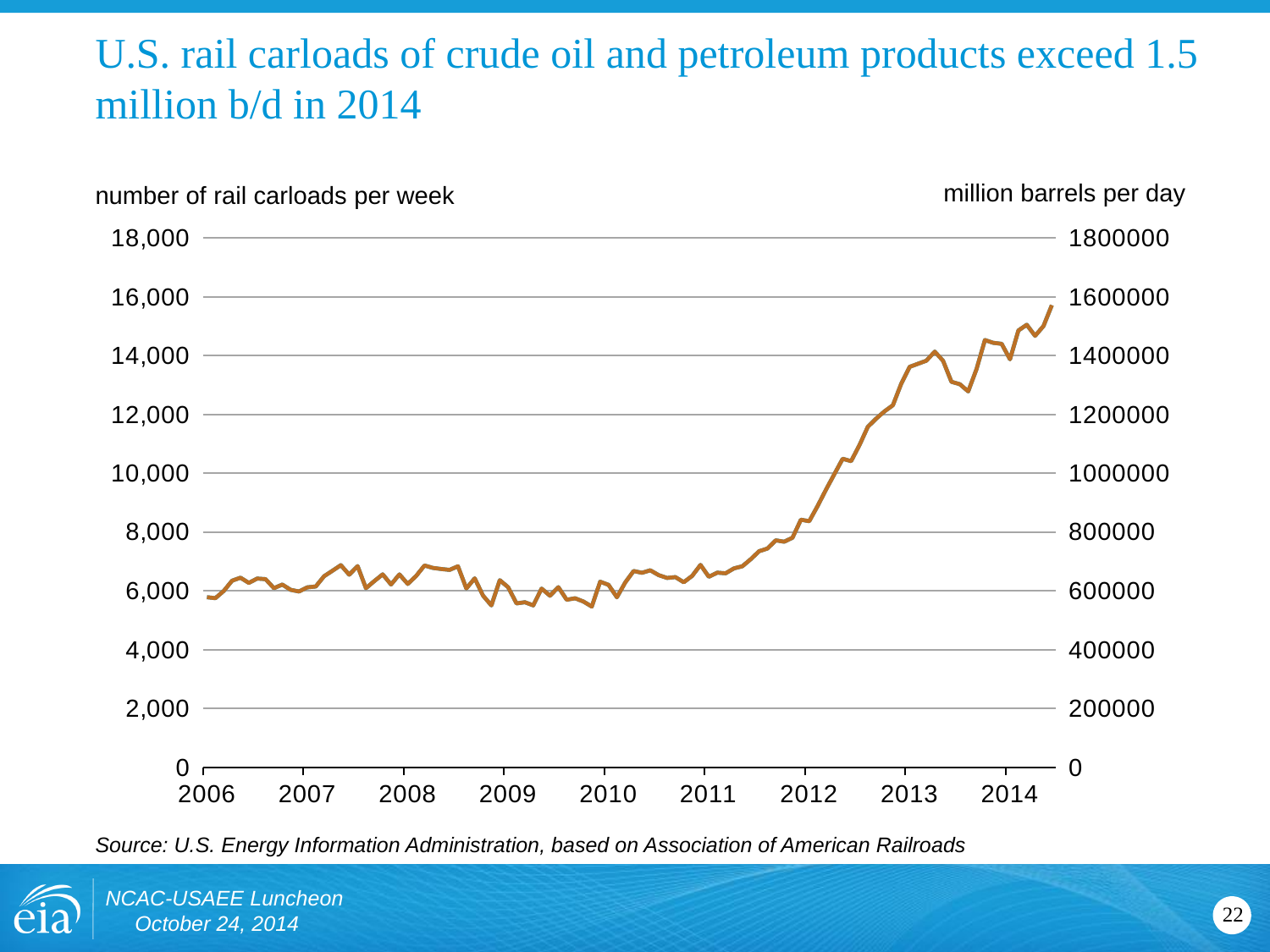
Is the value at the end of 2014 greater or less than 14,000 rail carloads per week? greater What kind of chart is shown on the slide? line chart Is the value at the end of 2014 greater or less than 1,400,000 barrels per day on the right axis? greater Is the value at the start of 2006 greater or less than 8,000 rail carloads per week? less Between 2011 and 2014, does the line rise or fall? rise What is the label of the right vertical axis? million barrels per day In which year does the line reach its highest point? 2014 Overall, do the values rise or fall from 2006 to 2014? rise What is the label of the left vertical axis? number of rail carloads per week How many years are labelled on the x axis? 9